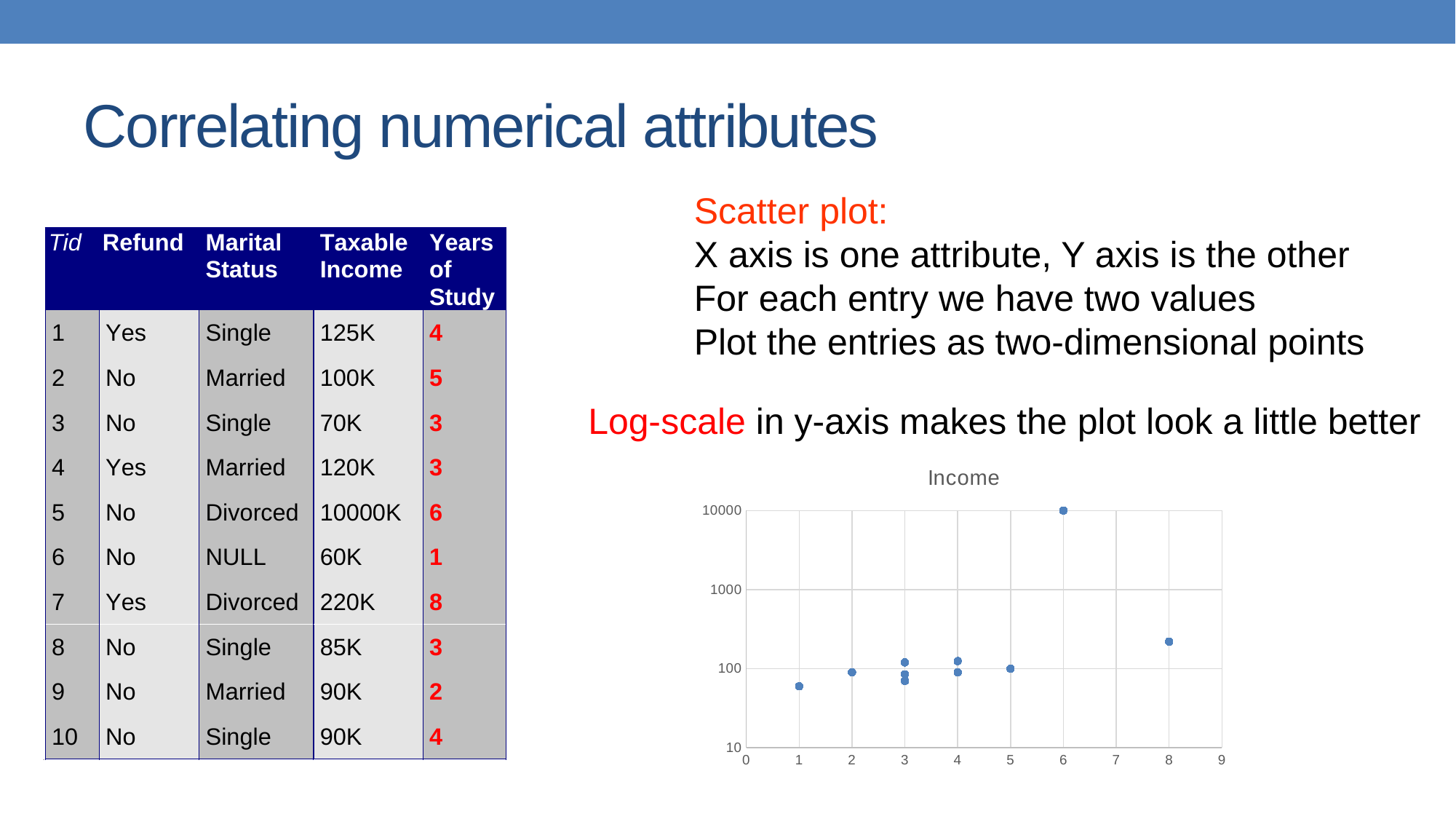
Which point has the larger y value, the one at x = 8 or the one at x = 5? x = 8 At which x value is the highest point in the scatter plot? 6 Is the value of the point at x = 1 greater or less than 100? less Which point has the larger y value, the one at x = 6 or the one at x = 8? x = 6 What is the y value of the point at x = 5? 100 What is the title of the chart? Income Is the value of the point at x = 6 greater or less than 1000? greater What is the y value of the point at x = 6? 10000 Is the value of the point at x = 8 greater or less than 100? greater What kind of chart is shown on the slide? scatter plot How many points are plotted in the scatter plot? 10 How many points are plotted at x = 3? 3